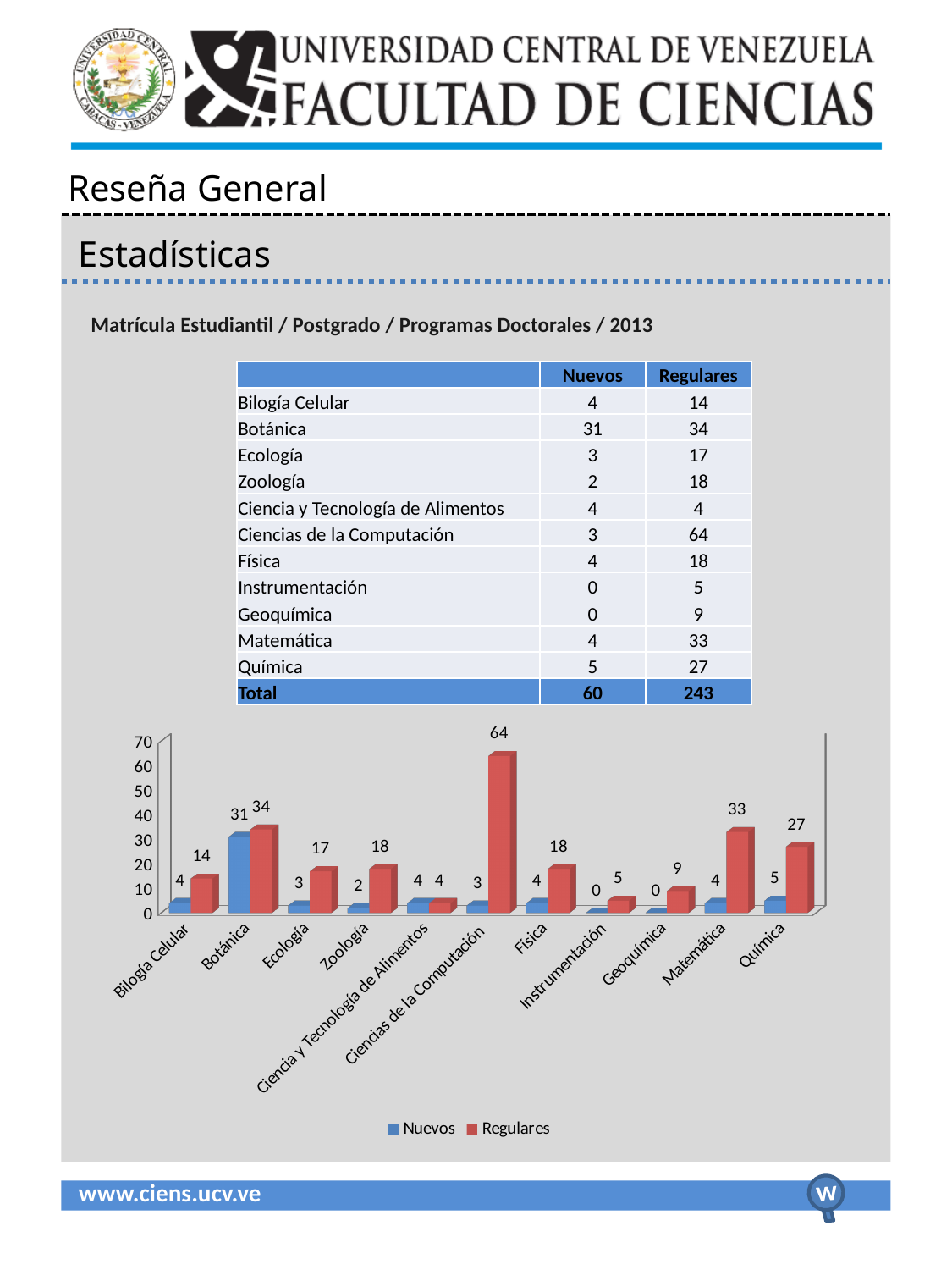
Which colour represents the Regulares series in the chart? red What is the Nuevos value for Instrumentación? 0 What is the difference between the Regulares and Nuevos values for Matemática? 29 Which category has the highest Regulares value? Ciencias de la Computación Which category has the highest Nuevos value? Botánica How many series does the legend list? 2 Which is larger, the Regulares value for Química or the Regulares value for Física? Química Is the Regulares value for Ciencias de la Computación greater or less than 60? greater What is the Nuevos value for Botánica? 31 What is the Regulares value for Ciencias de la Computación? 64 What kind of chart is shown on the slide? bar chart How many categories are shown on the x axis of the chart? 11